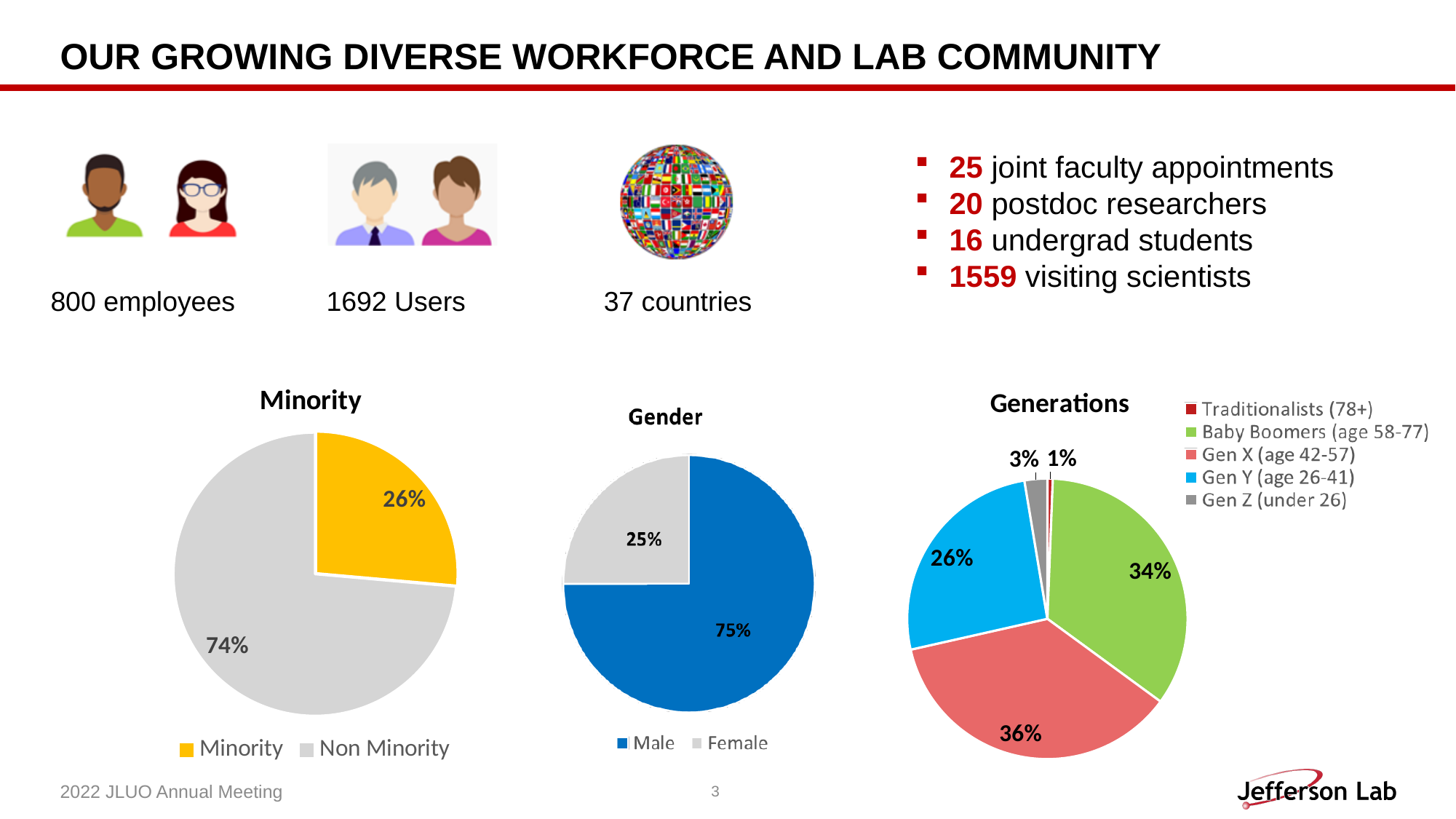
In the Generations pie chart, which generation has the smallest share? Traditionalists (78+) In the Gender pie chart, what is the difference in percentage points between Male and Female? 50 In the Generations pie chart, what share is Gen X (age 42-57)? 36% In the Gender pie chart, what share is Female? 25% In the Gender pie chart, what share is Male? 75% In the Generations pie chart, what is the difference in percentage points between Gen Y (age 26-41) and Gen Z (under 26)? 23 In the Generations pie chart, what share is Baby Boomers (age 58-77)? 34% How many categories does the legend of the Generations pie chart list? 5 What type of chart is the Gender chart? Pie chart In the Generations pie chart, which generation has the largest share? Gen X (age 42-57) In the Minority pie chart, what share is labelled Minority? 26%